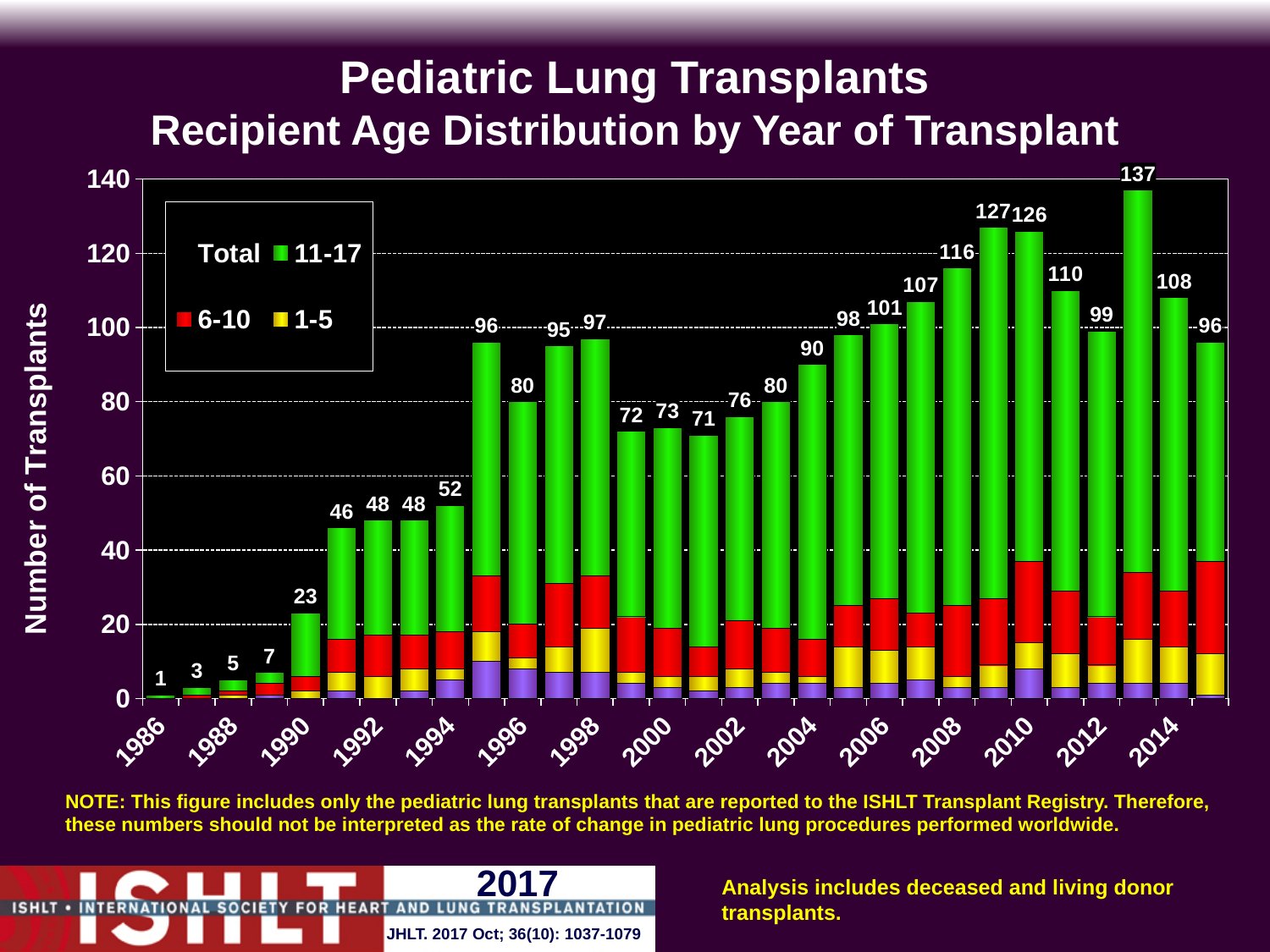
What is the label of the y-axis? Number of Transplants What is the difference between the total for 2013 and the total for 2009? 10 What is the total number of transplants labeled for 2006? 101 Do the total values rise or fall from 2004 to 2009? Rise What is the total number of transplants labeled for 2000? 73 Which year has the highest total number of transplants? 2013 How many yearly bars are plotted in the chart? 30 Which year has a larger total, 2008 or 2011? 2008 Which age group is shown in green in the legend? 11-17 What is the total number of pediatric lung transplants shown for 1990? 23 Which year has the lowest total number of transplants? 1986 What type of chart is shown on the slide? Stacked bar chart